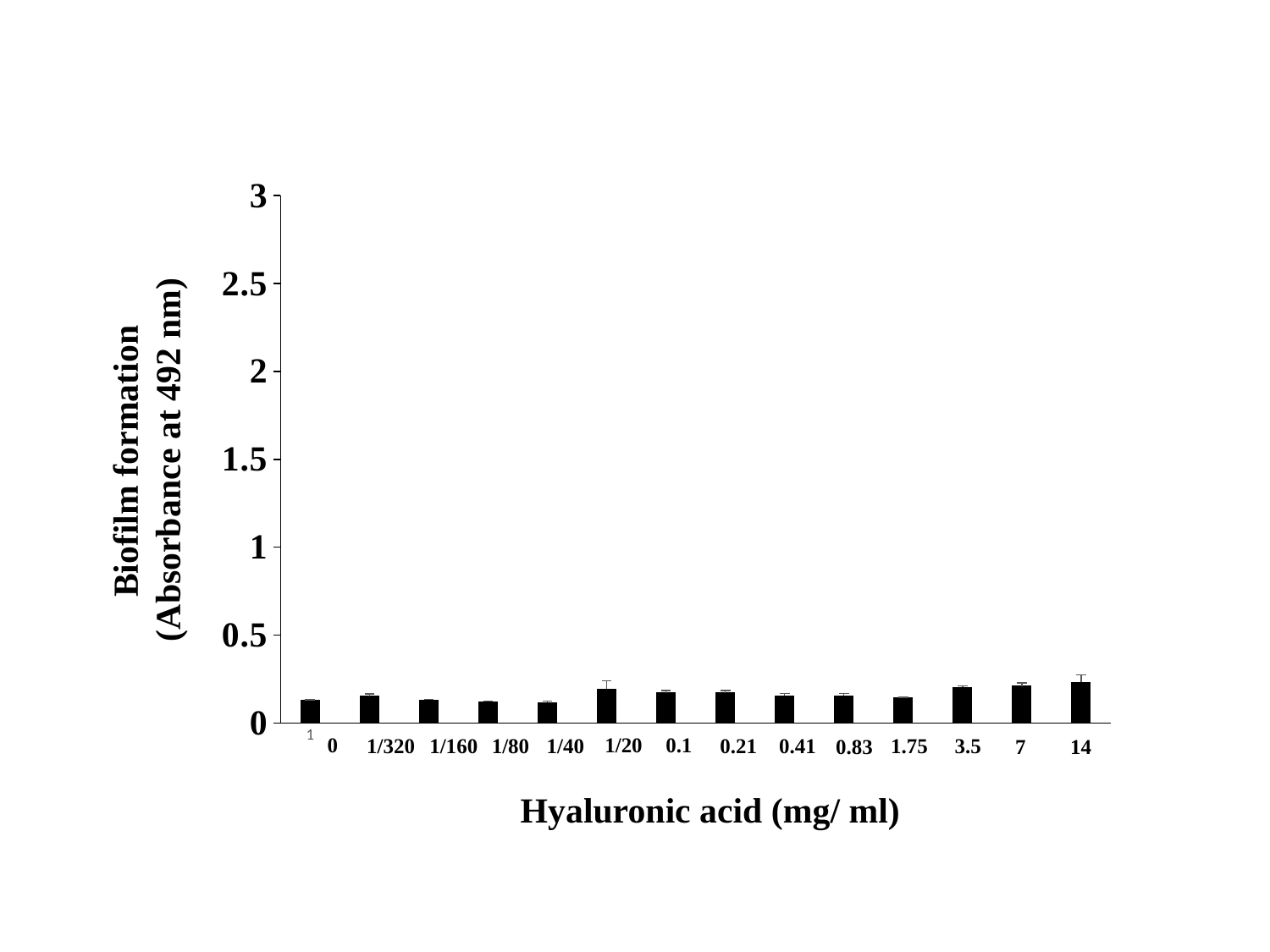
What is the label of the y axis? Biofilm formation (Absorbance at 492 nm) What kind of chart is shown on the slide? bar chart Which has the larger biofilm formation value: 7 mg/ml or 1.75 mg/ml hyaluronic acid? 7 Is the biofilm formation value for 0 mg/ml hyaluronic acid greater or less than 0.5? less What is the label of the x axis? Hyaluronic acid (mg/ ml) Which has the larger biofilm formation value: 1/20 mg/ml or 1/80 mg/ml hyaluronic acid? 1/20 How many hyaluronic acid concentrations (bars) are plotted on the x axis? 14 Is the biofilm formation value for 1/20 mg/ml hyaluronic acid greater or less than 1? less What is the highest tick value shown on the y axis? 3 Is the biofilm formation value for 14 mg/ml hyaluronic acid greater or less than 0.5? less Which has the larger biofilm formation value: 14 mg/ml or 1/40 mg/ml hyaluronic acid? 14